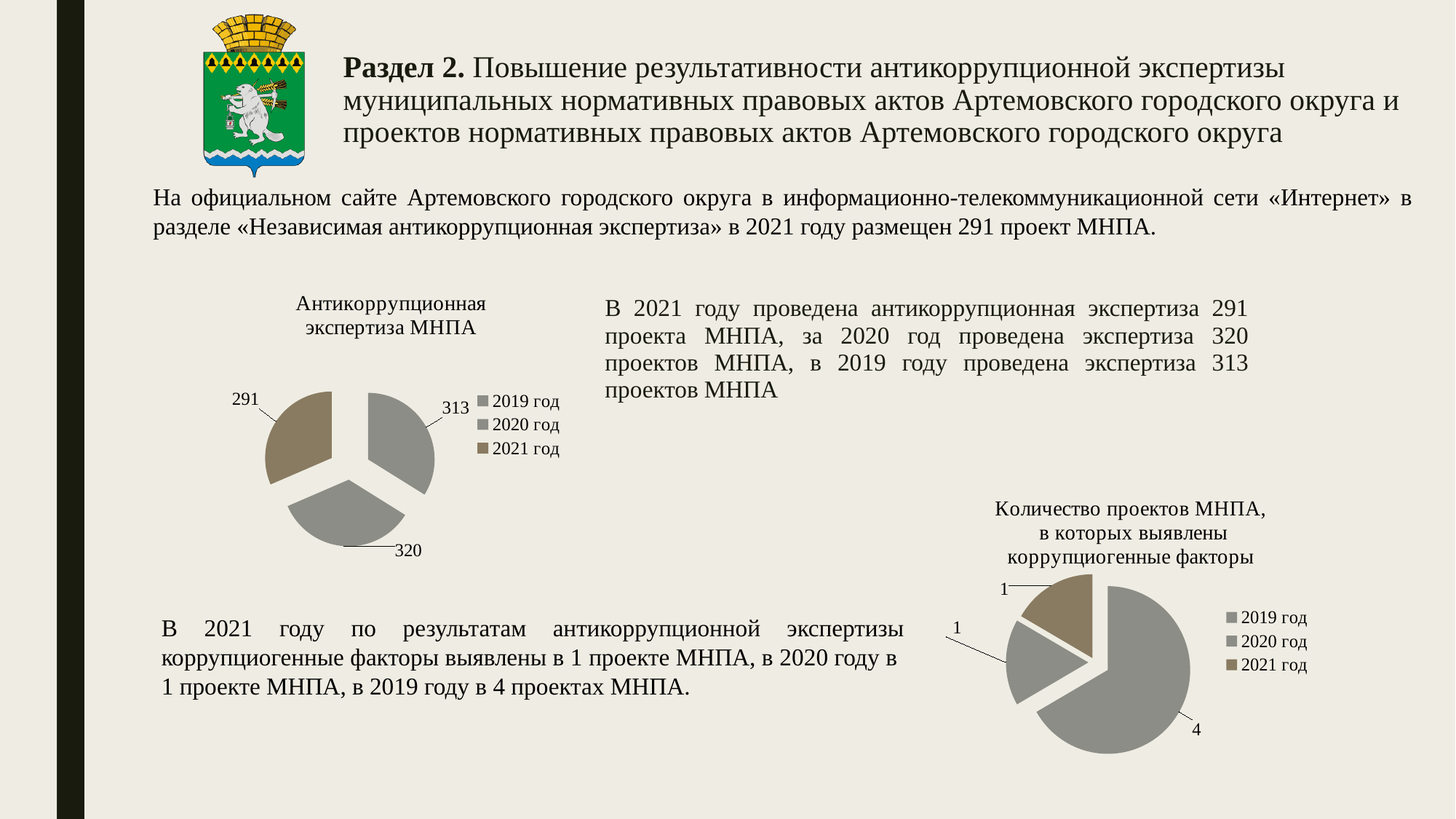
In the chart titled "Количество проектов МНПА, в которых выявлены коррупциогенные факторы", how many slices does the pie have? 3 In the chart titled "Количество проектов МНПА, в которых выявлены коррупциогенные факторы", what is the value for 2021 год? 1 In the chart titled "Количество проектов МНПА, в которых выявлены коррупциогенные факторы", which year has the largest slice? 2019 год In the chart titled "Антикоррупционная экспертиза МНПА", which year has the highest value? 2020 год In the chart titled "Антикоррупционная экспертиза МНПА", how many entries does the legend list? 3 In the chart titled "Количество проектов МНПА, в которых выявлены коррупциогенные факторы", what share of the total does 2019 год represent? 66.7% In the chart titled "Антикоррупционная экспертиза МНПА", what type of chart is used? Pie chart In the chart titled "Количество проектов МНПА, в которых выявлены коррупциогенные факторы", what is the value for 2019 год? 4 In the chart titled "Антикоррупционная экспертиза МНПА", what is the value for 2021 год? 291 In the chart titled "Антикоррупционная экспертиза МНПА", which year has the lowest value? 2021 год In the chart titled "Антикоррупционная экспертиза МНПА", what is the value for 2020 год? 320 In the chart titled "Антикоррупционная экспертиза МНПА", what is the difference between the values for 2020 год and 2021 год? 29